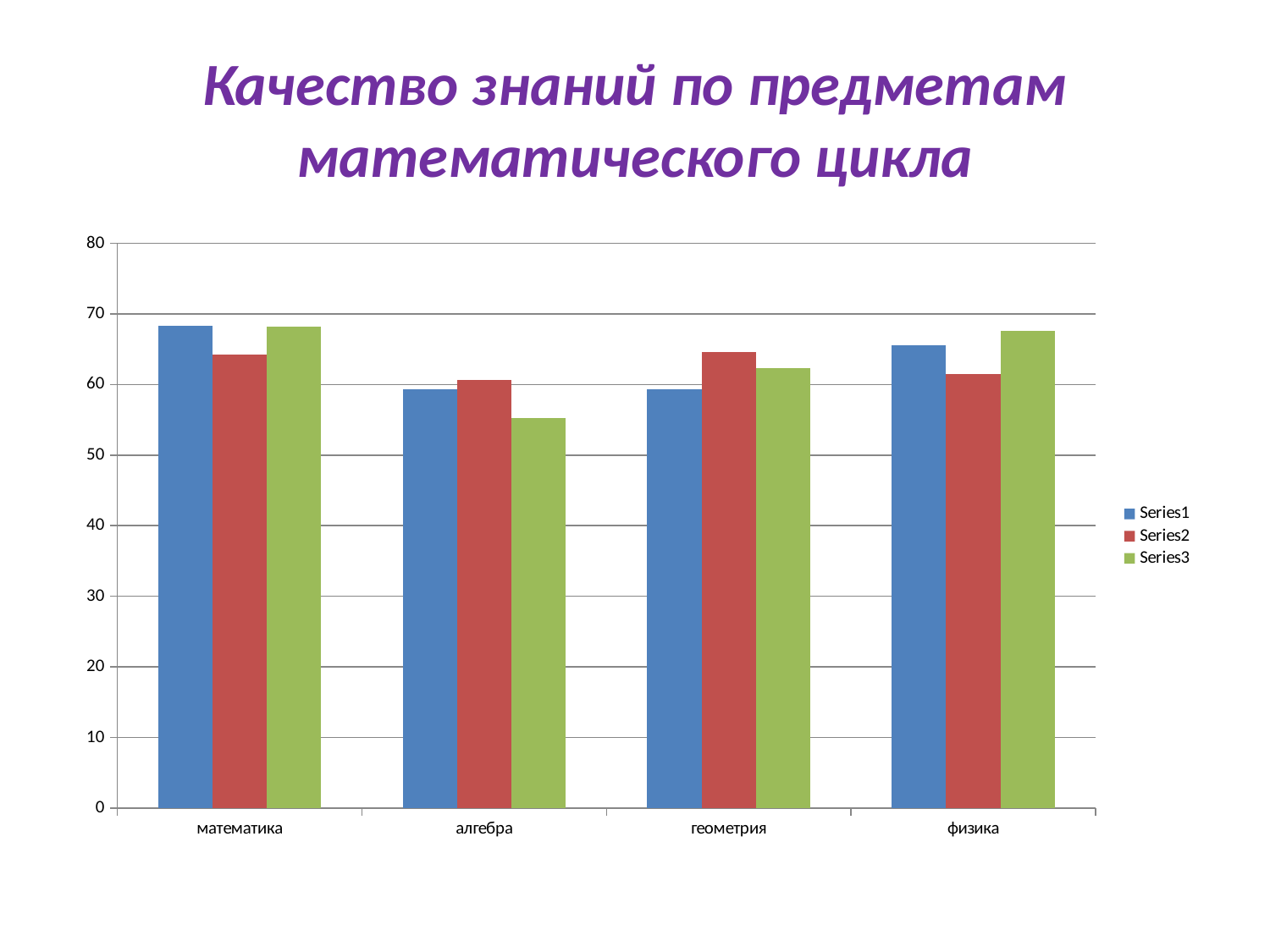
Is the value for Series2 in геометрия greater or less than 60? greater What kind of chart is shown on the slide? bar chart Is the value for Series1 in математика greater or less than 70? less Is the value for Series1 in математика greater or less than 60? greater What is the title of the chart on the slide? Качество знаний по предметам математического цикла For which category is the Series3 value the lowest? алгебра How many series does the legend list? 3 How many categories are shown on the x axis of the chart? 4 In алгебра, which is larger: the value for Series2 or the value for Series3? Series2 In геометрия, which is larger: the value for Series1 or the value for Series2? Series2 Which colour represents Series2 in the chart? red